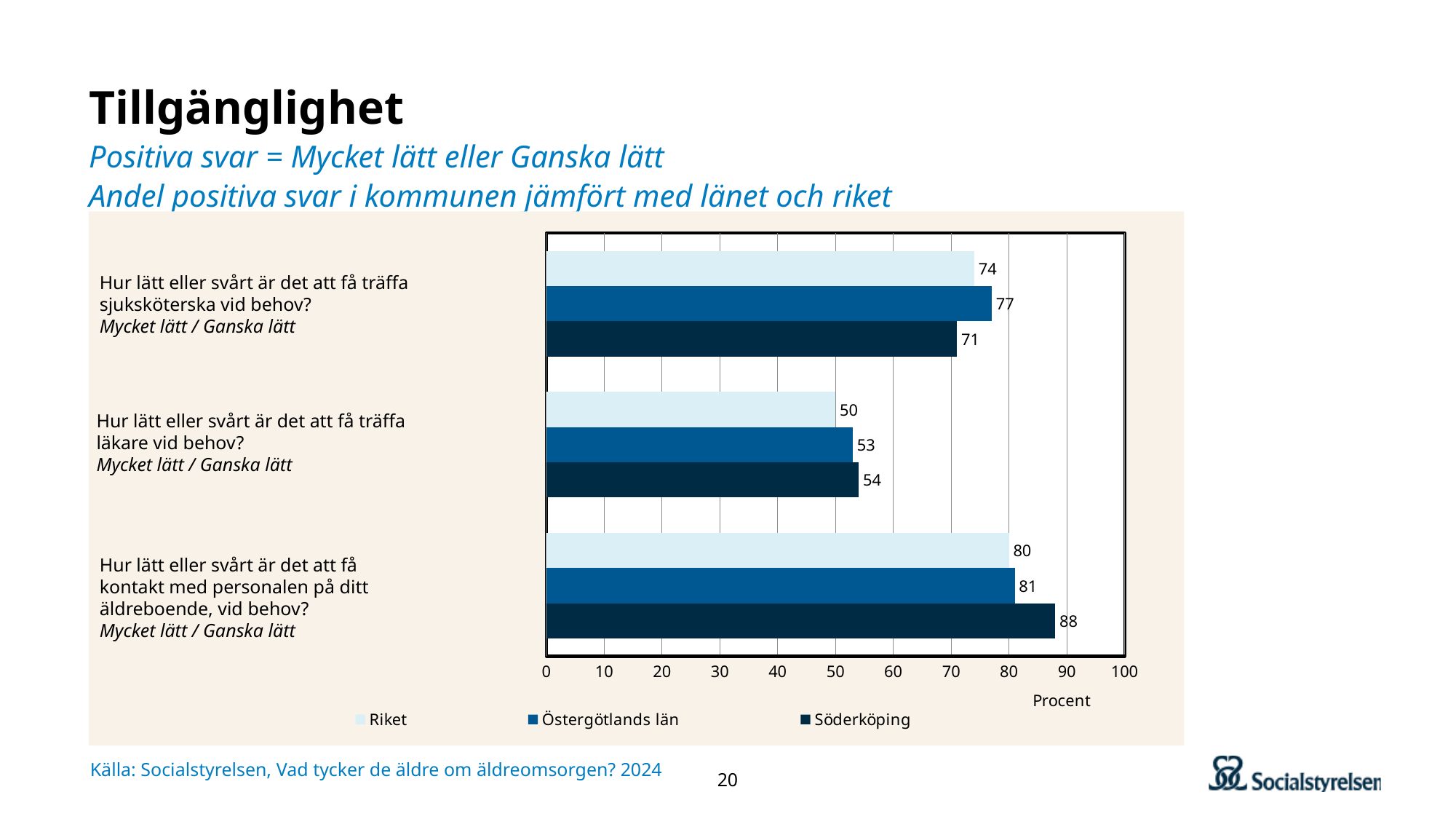
What kind of chart is shown on the slide? Bar chart What is the value for Riket on the question about meeting a doctor when needed ("Hur lätt eller svårt är det att få träffa läkare vid behov?")? 50 Which is larger on the question about meeting a nurse when needed: Riket or Söderköping? Riket How many series does the legend list? 3 What unit is shown on the horizontal axis of the chart? Procent How many questions (categories) are shown in the chart? 3 What is the difference between Söderköping and Riket on the question about getting in contact with staff at the care home? 8 What is the value for Söderköping on the question about getting in contact with staff at the care home ("Hur lätt eller svårt är det att få kontakt med personalen på ditt äldreboende, vid behov?")? 88 Which series has the lowest value on the question about meeting a doctor when needed? Riket Which series has the highest value on the question about meeting a nurse when needed? Östergötlands län Is the value for Söderköping on the question about meeting a doctor when needed greater or less than 60? less What is the value for Östergötlands län on the question about meeting a nurse when needed ("Hur lätt eller svårt är det att få träffa sjuksköterska vid behov?")? 77